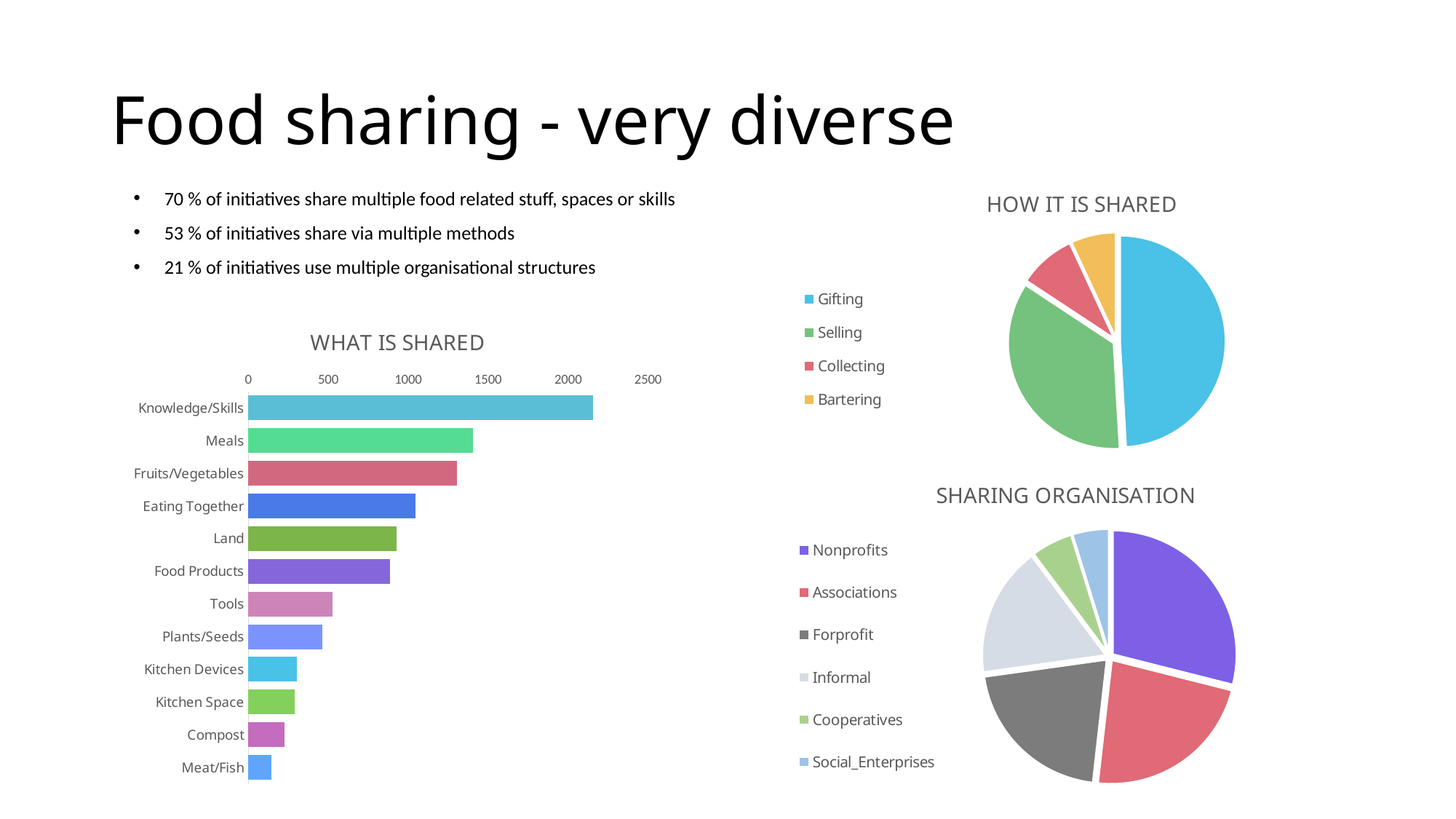
What type of chart is the "HOW IT IS SHARED" chart? pie chart In the "WHAT IS SHARED" chart, which is larger, Meals or Tools? Meals In the "WHAT IS SHARED" chart, which category has the lowest value? Meat/Fish How many categories are shown in the "WHAT IS SHARED" chart? 12 In the "WHAT IS SHARED" chart, is the value for Meals greater or less than 1500? less In the "HOW IT IS SHARED" chart, which category has the largest slice? Gifting In the "HOW IT IS SHARED" chart, which category has the smallest slice? Bartering In the "WHAT IS SHARED" chart, is the value for Meat/Fish greater or less than 500? less What type of chart is the "WHAT IS SHARED" chart? bar chart In the "WHAT IS SHARED" chart, is the value for Knowledge/Skills greater or less than 2000? greater How many entries does the legend of the "SHARING ORGANISATION" chart list? 6 In the "WHAT IS SHARED" chart, which category has the highest value? Knowledge/Skills